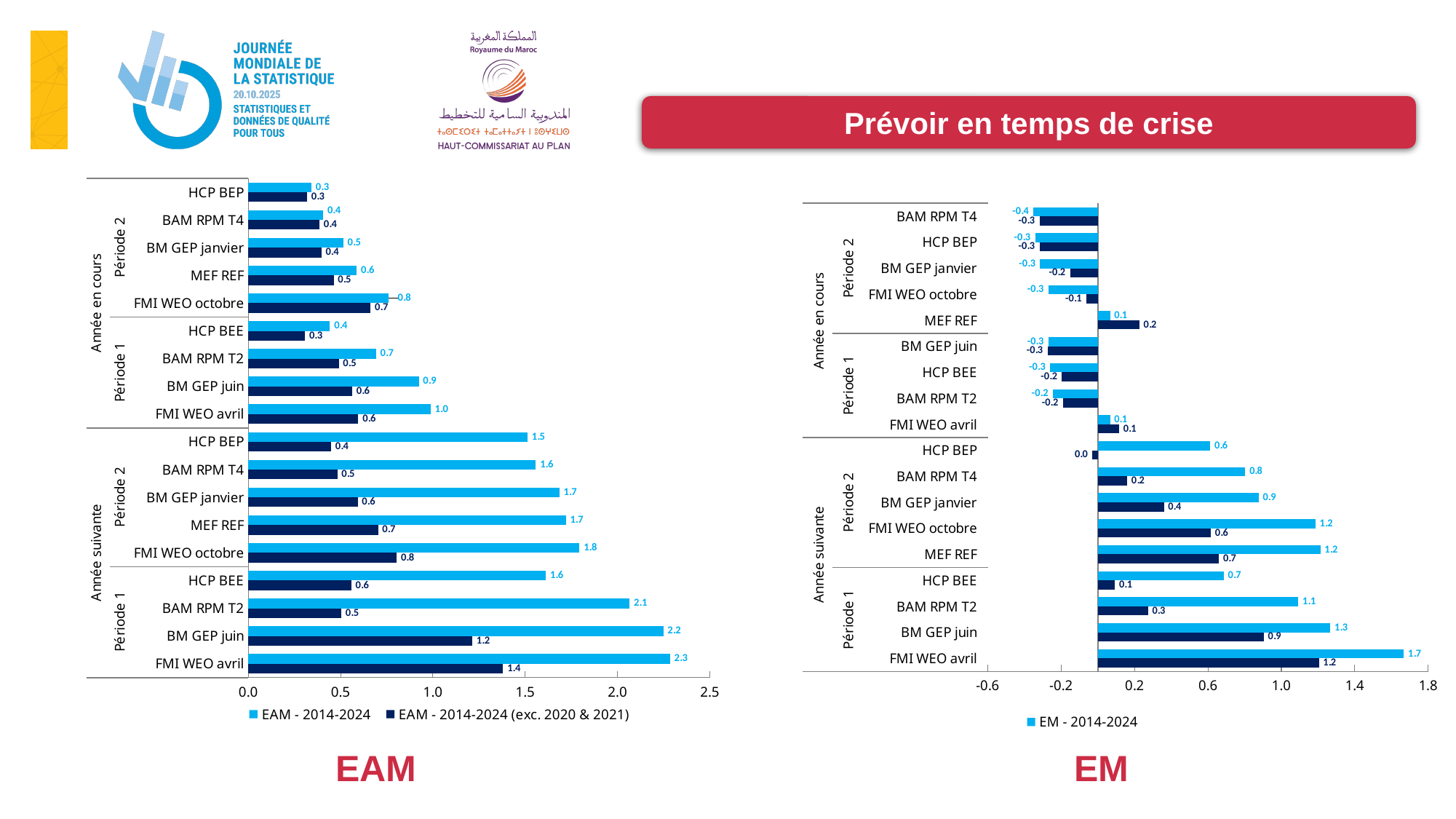
In the EM chart, is the EM - 2014-2024 value for BM GEP juin in Année suivante, Période 1 larger or smaller than that for BAM RPM T2 in the same period? larger In the EAM chart, what is the difference between the EAM - 2014-2024 value and the EAM - 2014-2024 (exc. 2020 & 2021) value for BAM RPM T2 in Année suivante, Période 1? 1.6 What type of chart is the EAM chart? bar chart In the EAM chart, what is the EAM - 2014-2024 (exc. 2020 & 2021) value for BM GEP juin in Année suivante, Période 1? 1.2 In the EM chart, which category has the lowest EM - 2014-2024 value? BAM RPM T4 (Année en cours, Période 2) In the EM chart, how many series does the legend list? 1 In the EAM chart, what is the EAM - 2014-2024 value for MEF REF in Année en cours, Période 2? 0.6 In the EAM chart, which category has the highest EAM - 2014-2024 value? FMI WEO avril (Année suivante, Période 1) In the EM chart, what is the EM - 2014-2024 value for BAM RPM T4 in Année en cours, Période 2? -0.4 In the EAM chart, how many series does the legend list? 2 In the EAM chart, what is the EAM - 2014-2024 value for FMI WEO avril in Année suivante, Période 1? 2.3 In the EM chart, what is the EM - 2014-2024 value for FMI WEO avril in Année suivante, Période 1? 1.7